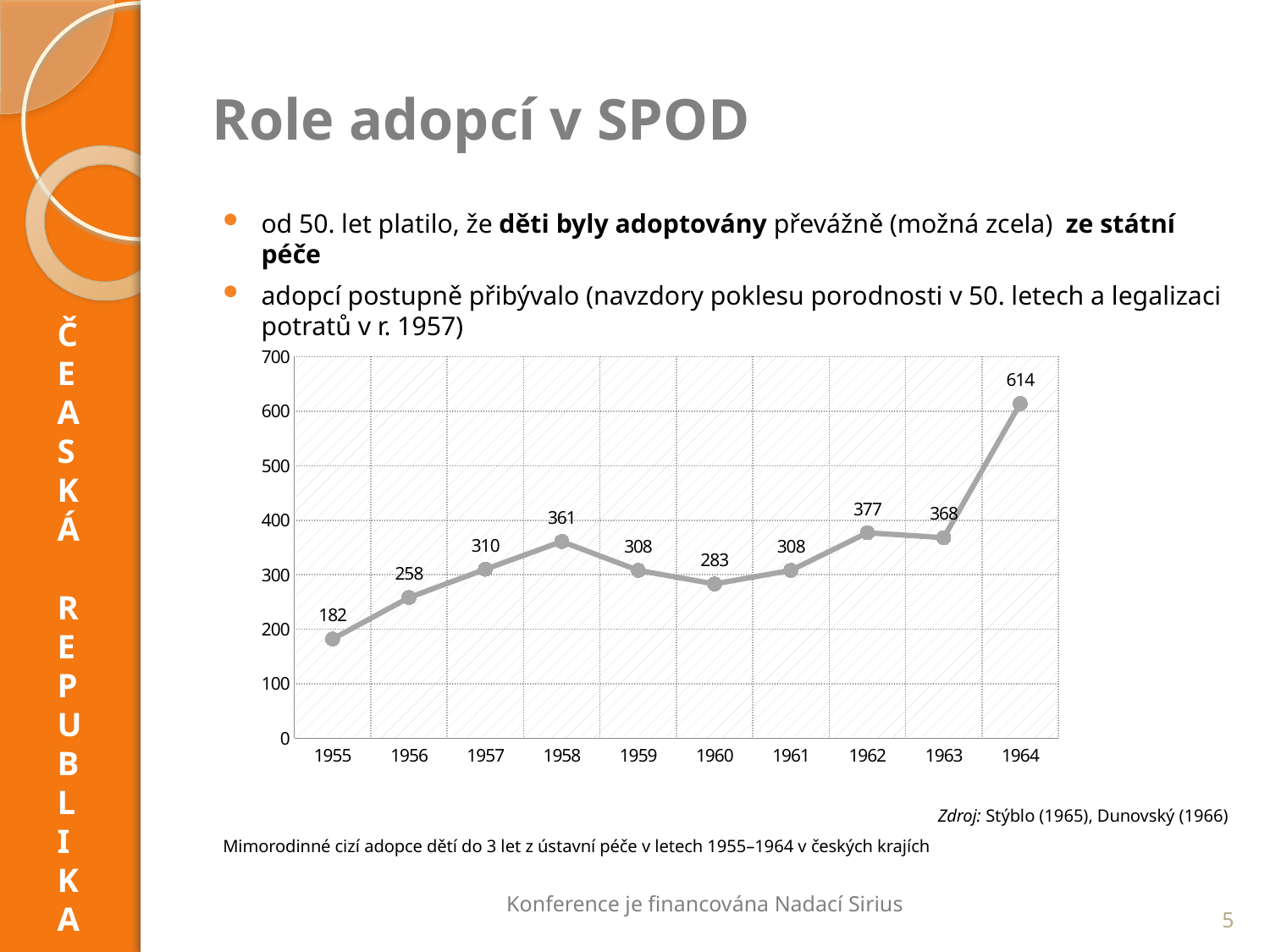
Does the value rise or fall from 1958 to 1959? fall What is the difference between the values for 1956 and 1955? 76 How many years are plotted on the chart? 10 What is the value for 1964? 614 Which is larger, the value for 1962 or the value for 1963? 1962 What is the value for 1955? 182 What is the difference between the values for 1964 and 1963? 246 Which year has the lowest value? 1955 Which year has the highest value? 1964 Is the value for 1960 greater or less than 300? less What kind of chart is shown on the slide? line chart What is the value for 1958? 361